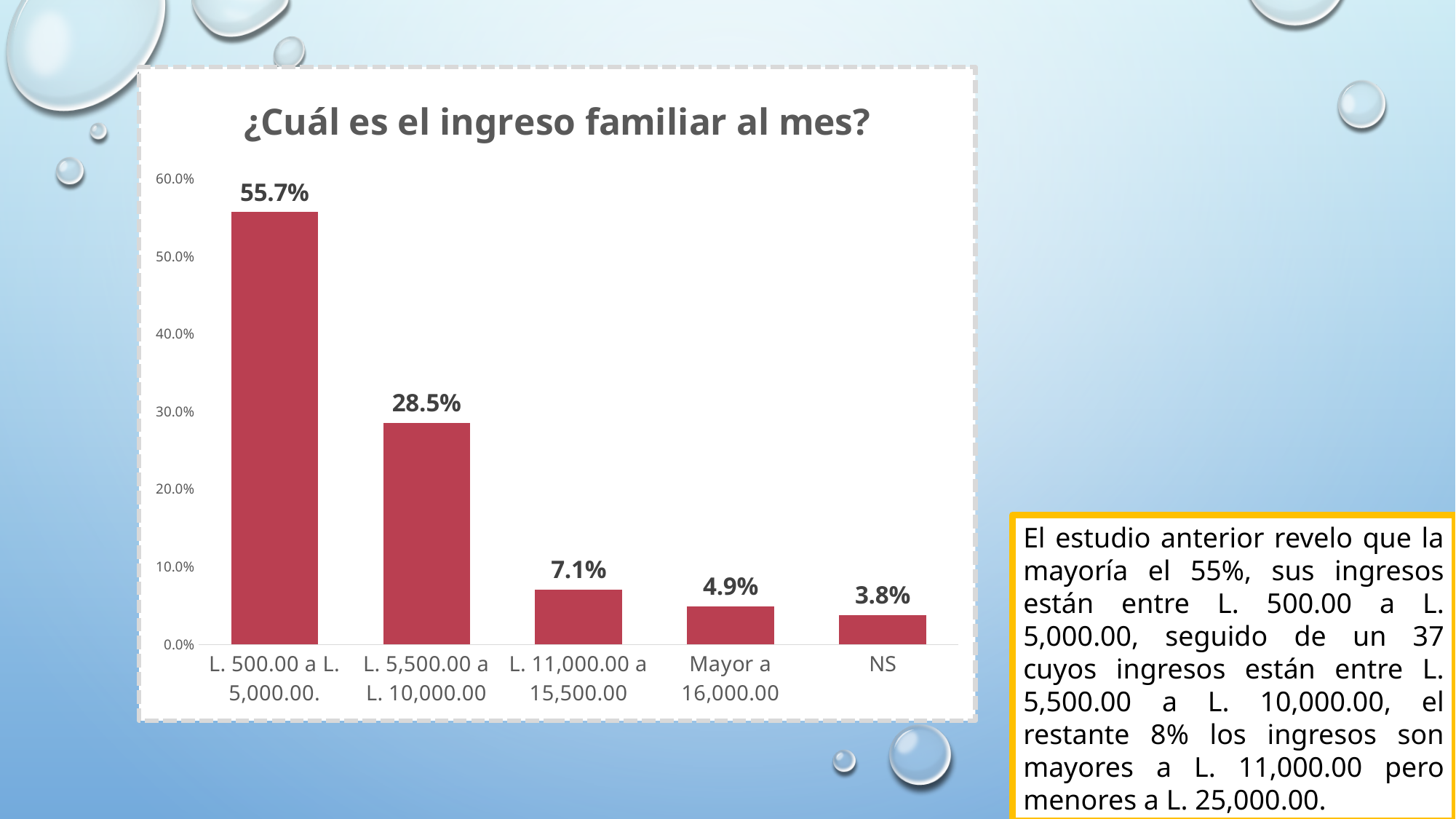
What is the value for the category 'L. 5,500.00 a L. 10,000.00'? 28.5% What is the value for the category 'L. 11,000.00 a 15,500.00'? 7.1% What is the title of the chart? ¿Cuál es el ingreso familiar al mes? What is the value for the category 'L. 500.00 a L. 5,000.00.'? 55.7% Which is larger, the value for 'Mayor a 16,000.00' or the value for 'NS'? Mayor a 16,000.00 How many categories are shown in the chart? 5 What kind of chart is shown on the slide? Bar chart Which category has the highest value? L. 500.00 a L. 5,000.00. What is the value for the category 'NS'? 3.8% What is the value for the category 'Mayor a 16,000.00'? 4.9% What is the difference between the values for 'L. 500.00 a L. 5,000.00.' and 'L. 5,500.00 a L. 10,000.00'? 27.2% Which category has the lowest value? NS